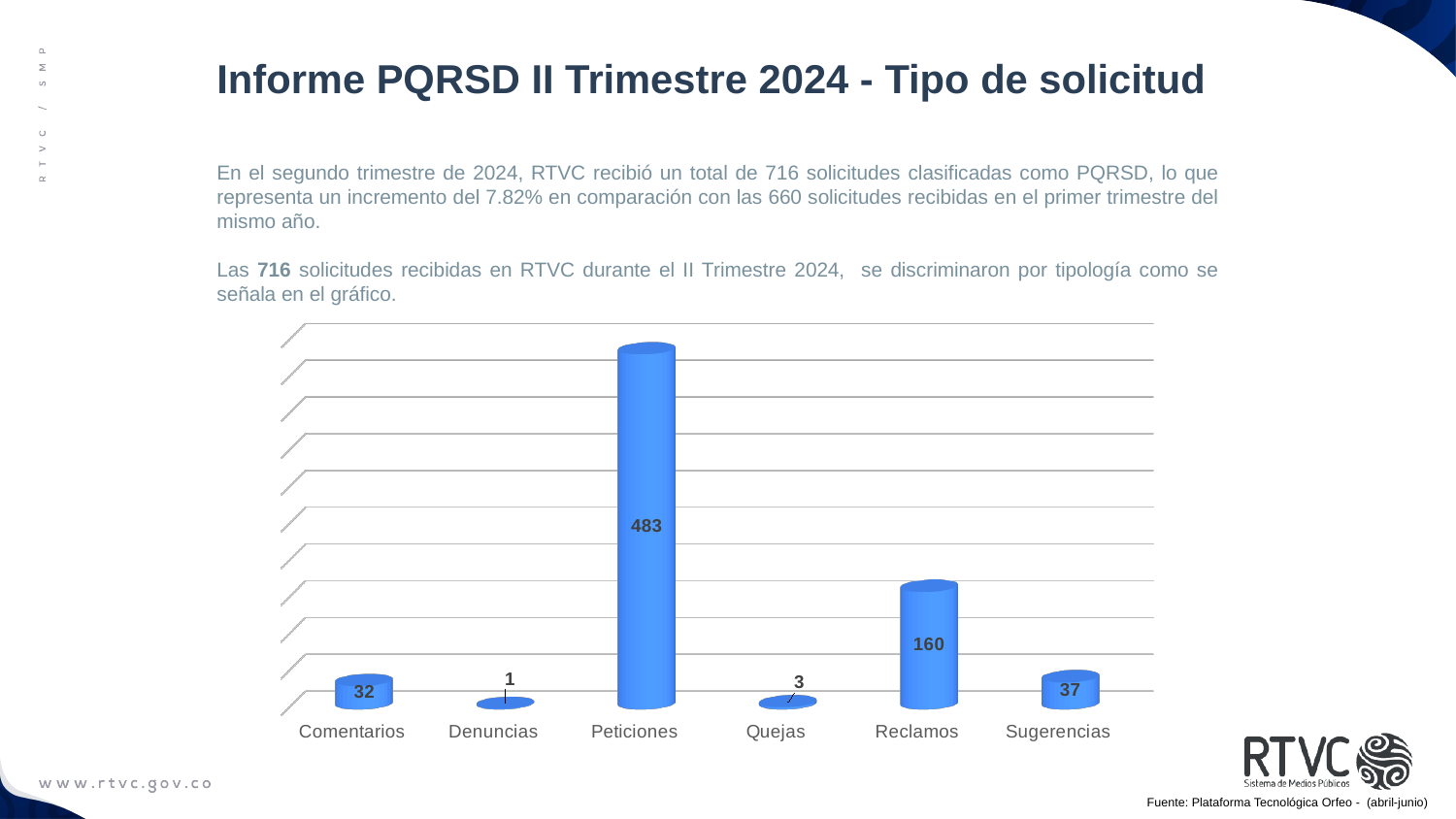
What is the value for Reclamos? 160 Which is larger, the value for Quejas or the value for Denuncias? Quejas What is the title of the slide containing the chart? Informe PQRSD II Trimestre 2024 - Tipo de solicitud What is the value for Comentarios? 32 Which category has the lowest value? Denuncias What is the difference between the values for Sugerencias and Comentarios? 5 What kind of chart is shown on the slide? Bar chart What is the value for Sugerencias? 37 Which category has the highest value? Peticiones What is the value for Peticiones? 483 How many categories are shown on the x axis? 6 What is the difference between the values for Peticiones and Reclamos? 323